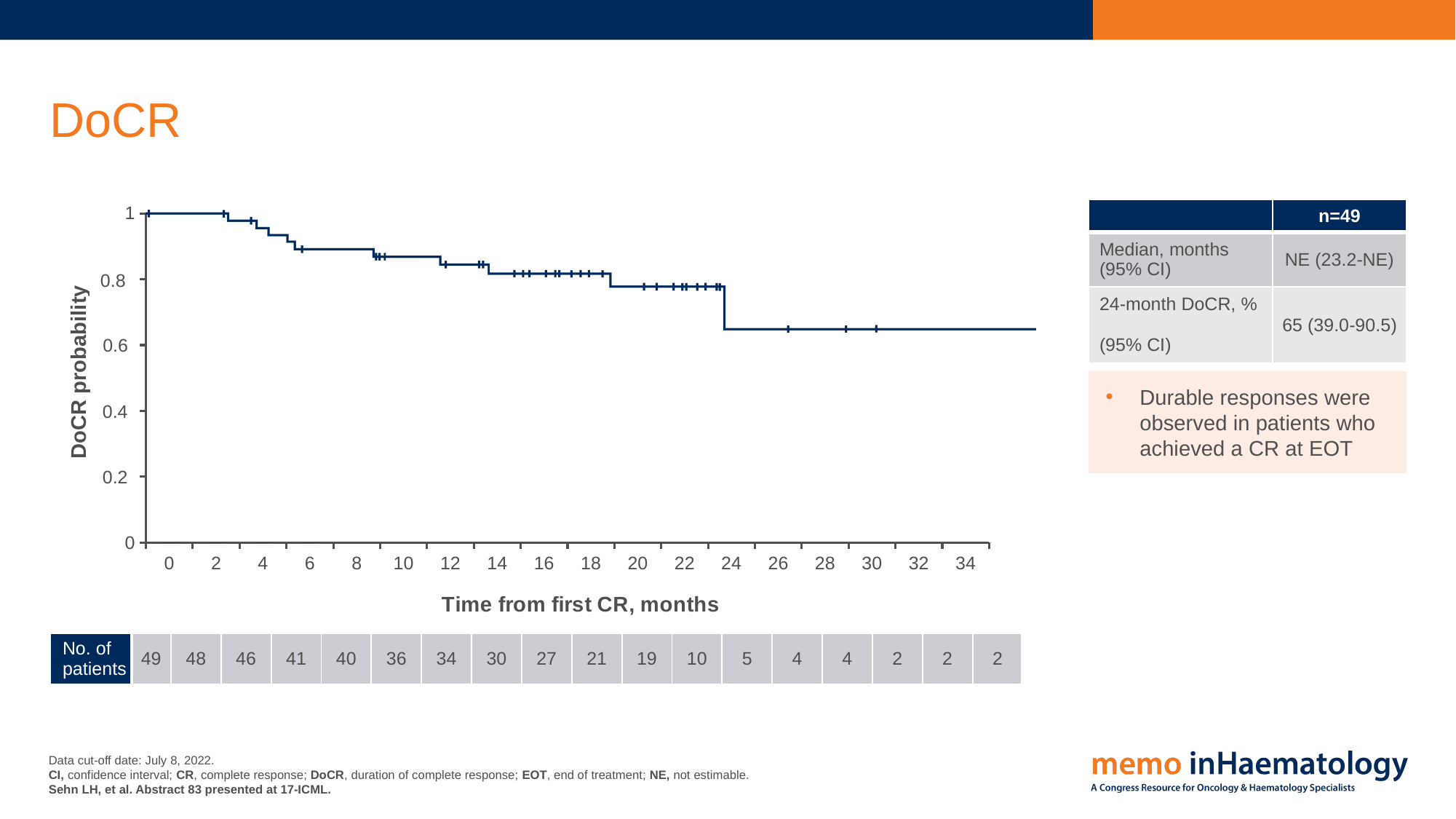
How many patients are at risk at 0 months according to the No. of patients row? 49 How many time points are listed in the No. of patients row below the chart? 18 What is the label of the x axis of the chart? Time from first CR, months Does the DoCR probability curve rise or fall as time from first CR increases? Fall Is the DoCR probability at 10 months greater or less than 0.8? greater How many patients are at risk at 24 months according to the No. of patients row? 5 How many patients are at risk at 12 months according to the No. of patients row? 34 What is the label of the y axis of the chart? DoCR probability Is the DoCR probability at 30 months greater or less than 0.8? less What kind of chart is shown on the slide? Line chart (Kaplan-Meier curve) Is the DoCR probability at 20 months greater or less than 0.6? greater What is the difference between the number of patients at risk at 0 months and at 24 months? 44